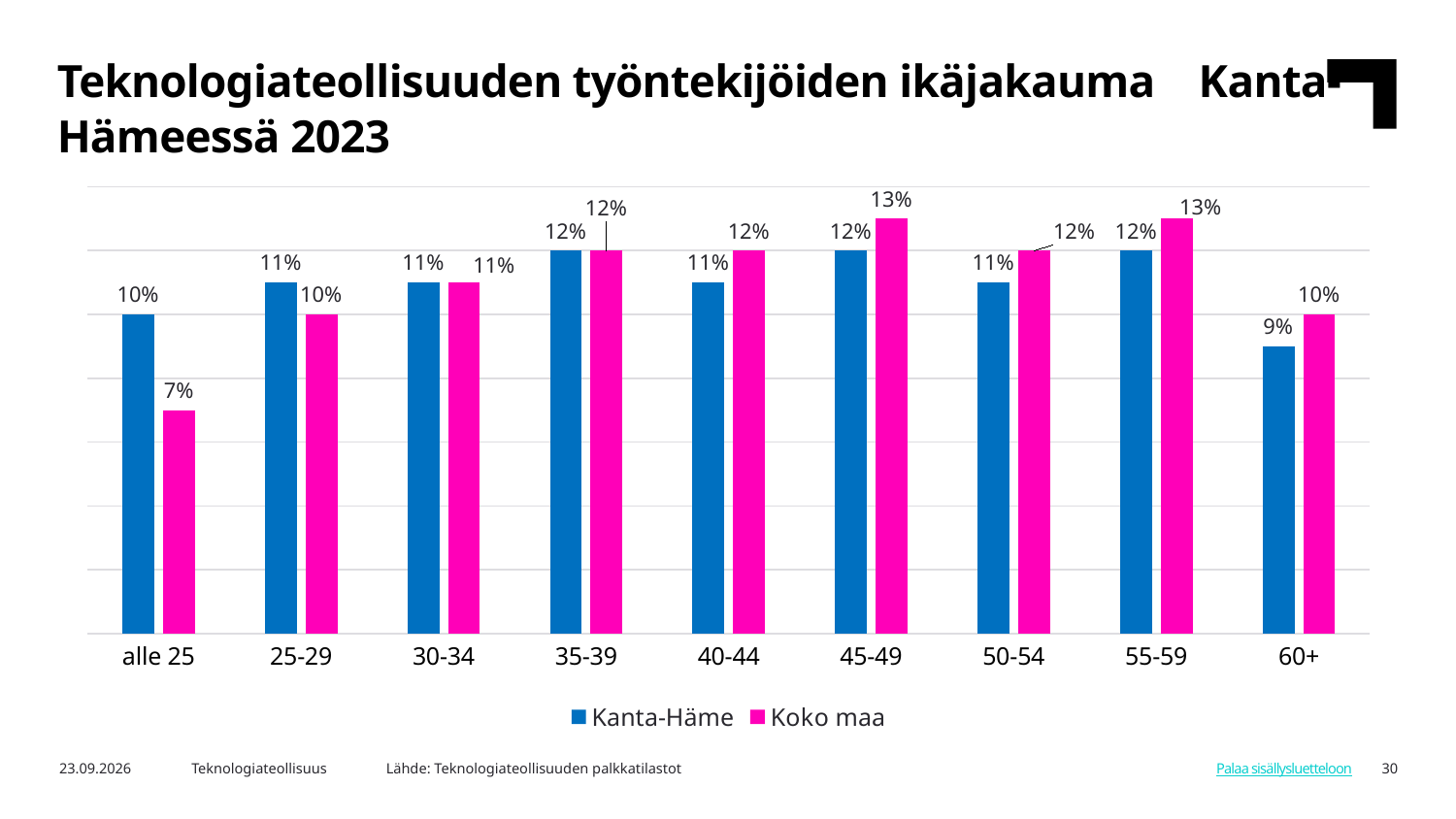
Which age group has the lowest value for Kanta-Häme? 60+ What is the value for Kanta-Häme in the 60+ age group? 9% What is the value for Koko maa in the alle 25 age group? 7% What is the value for Kanta-Häme in the alle 25 age group? 10% How many series does the legend list? 2 How many age groups are shown on the x axis? 9 Which age group has the lowest value for Koko maa? alle 25 What is the difference between the Kanta-Häme and Koko maa values in the alle 25 age group? 3 percentage points What is the value for Koko maa in the 45-49 age group? 13% In the alle 25 age group, which series has the larger value, Kanta-Häme or Koko maa? Kanta-Häme What kind of chart is shown on the slide? Bar chart In the 45-49 age group, which series has the larger value, Kanta-Häme or Koko maa? Koko maa